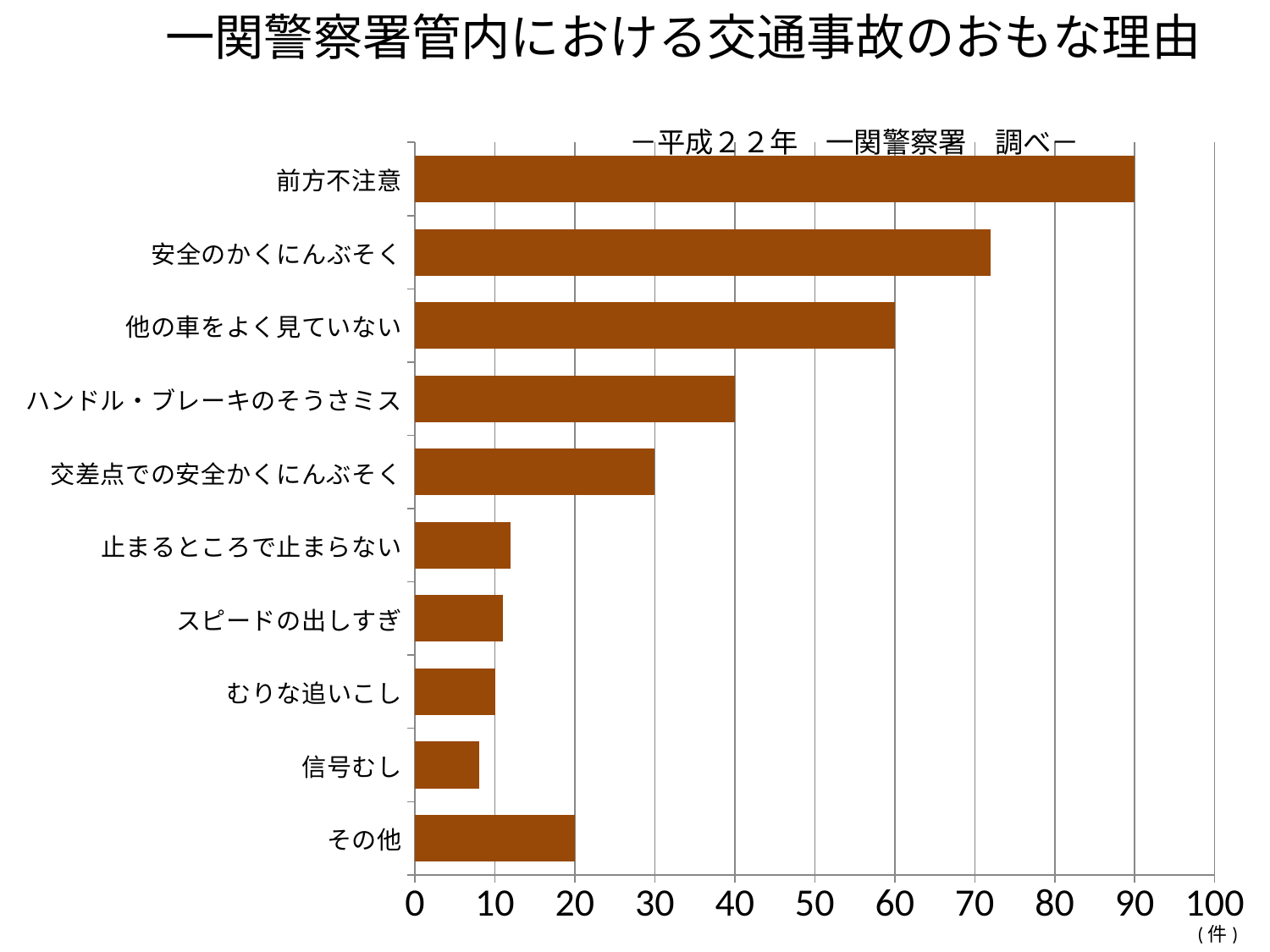
What kind of chart is shown on the slide? bar chart What is the value for 他の車をよく見ていない? 60 What is the value for ハンドル・ブレーキのそうさミス? 40 What is the value for その他? 20 Which reason has the lowest value in the chart? 信号むし Which reason has the highest value in the chart? 前方不注意 What is the difference between the values for 前方不注意 and 他の車をよく見ていない? 30 What is the value for 前方不注意? 90 Which is larger, the value for ハンドル・ブレーキのそうさミス or the value for 交差点での安全かくにんぶそく? ハンドル・ブレーキのそうさミス Is the value for 安全のかくにんぶそく greater or less than 70? greater How many categories (reasons) are plotted in the chart? 10 What is the title of the chart on the slide? 一関警察署管内における交通事故のおもな理由